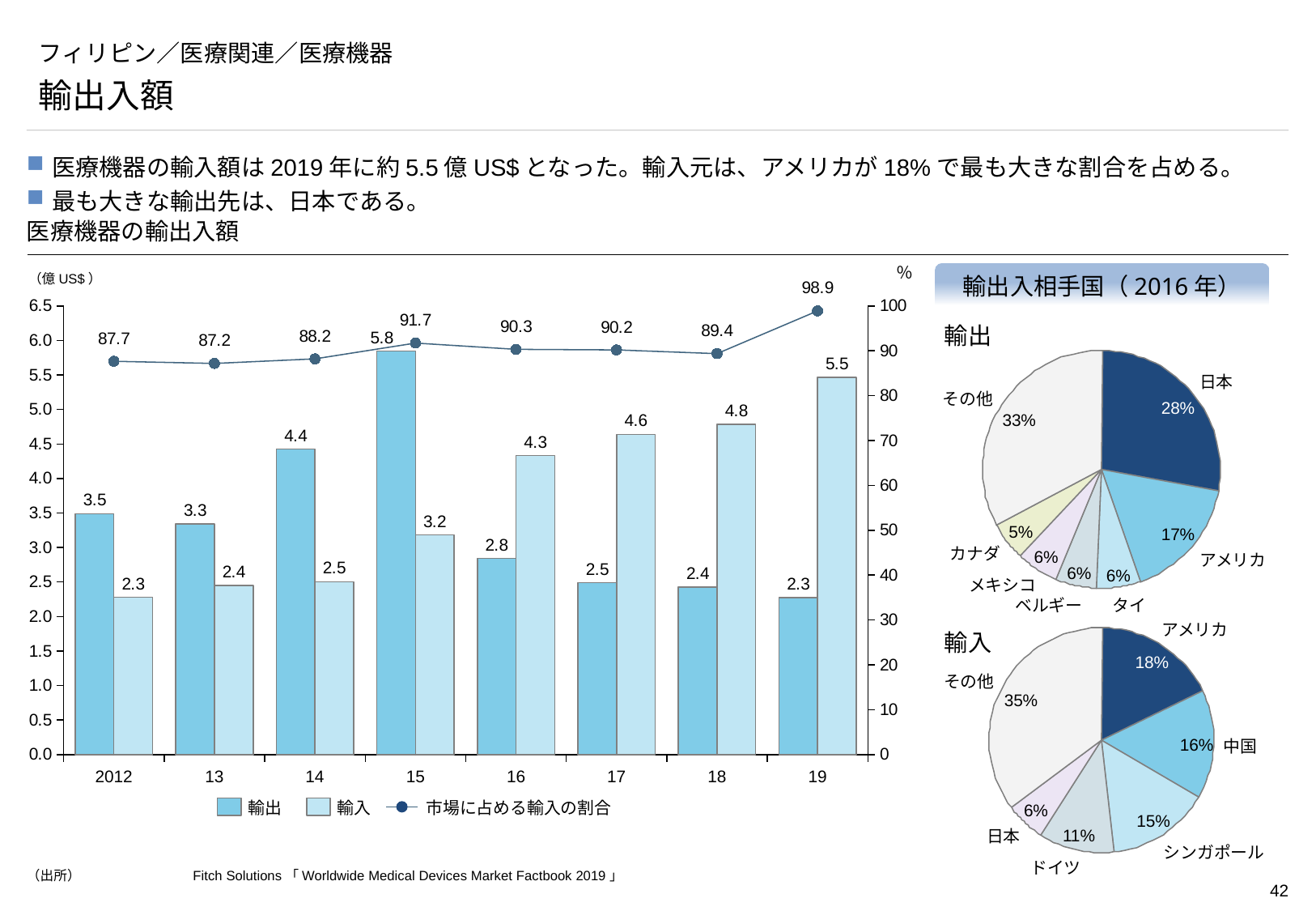
In the 医療機器の輸出入額 chart, which year has the highest 輸出 value? 15 In the 医療機器の輸出入額 chart, how many series does the legend list? 3 In the 医療機器の輸出入額 chart, what is the 市場に占める輸入の割合 value for 15? 91.7 In the 医療機器の輸出入額 chart, which year has the lowest 輸入 value? 2012 In the 輸出 pie chart, what share does 日本 have? 28% In the 輸入 pie chart, what share does ドイツ have? 11% In the 医療機器の輸出入額 chart, what is the 輸出 value for 2012? 3.5 In the 医療機器の輸出入額 chart, which is larger for 16: 輸出 or 輸入? 輸入 In the 医療機器の輸出入額 chart, what is the difference between the 輸入 value for 19 and the 輸入 value for 2012? 3.2 In the 医療機器の輸出入額 chart, what is the 輸入 value for 19? 5.5 In the 医療機器の輸出入額 chart, does the 輸入 series rise or fall from 2012 to 19? rise In the 輸入 pie chart, which country has the largest share apart from その他? アメリカ